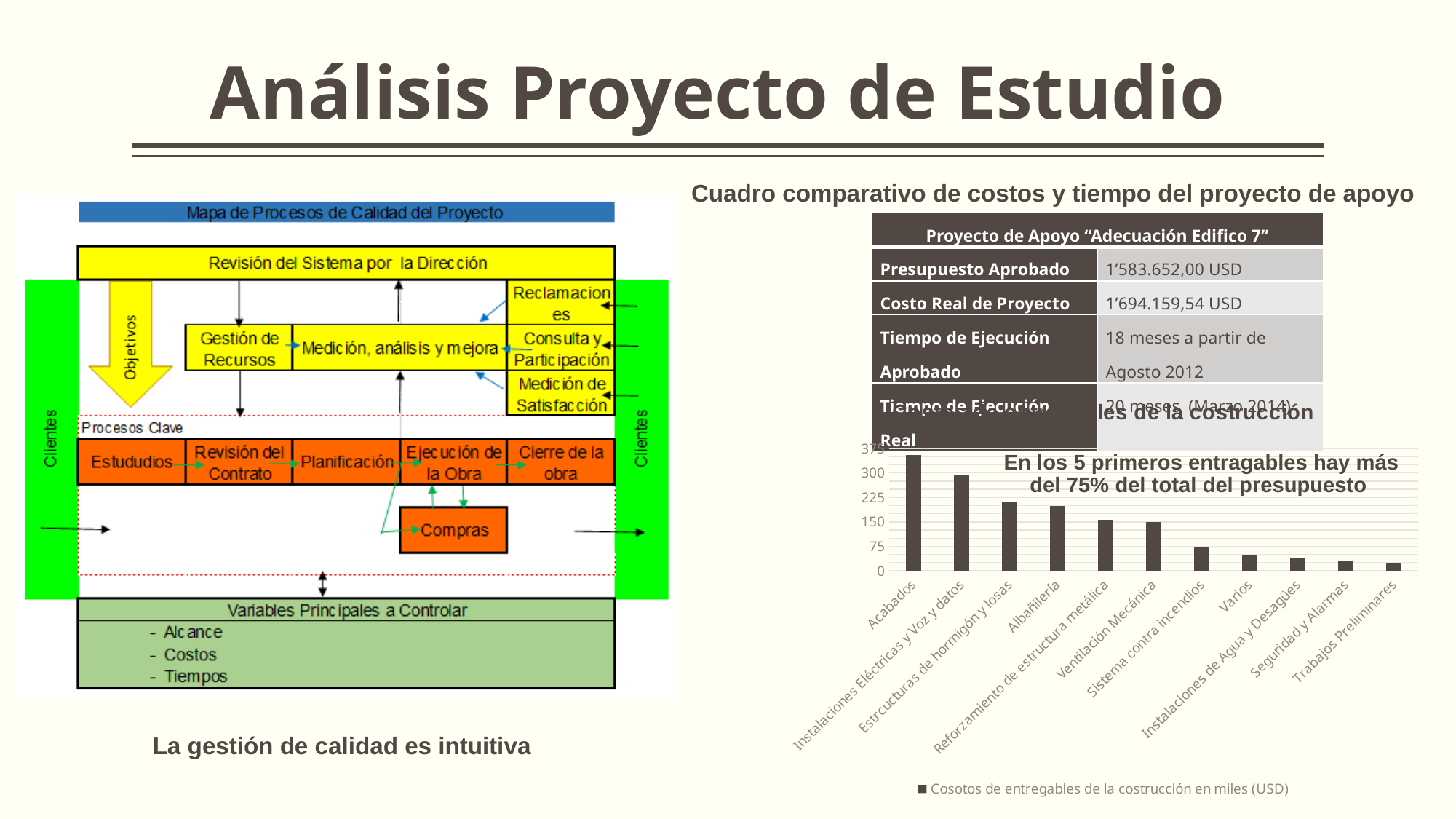
Is the value for Sistema contra incendios greater or less than 150? less What kind of chart is shown at the bottom right of the slide? bar chart Is the value for Estructuras de hormigón y losas greater or less than 150? greater Do the bar values rise or fall from left to right along the x axis? fall How many series does the legend of the bar chart list? 1 Which category has the lowest bar in the chart? Trabajos Preliminares Is the value for Acabados greater or less than 300? greater What does the legend of the bar chart say the series represents? Cosotos de entregables de la costrucción en miles (USD) Which is larger, the value for Acabados or the value for Varios? Acabados How many categories (entregables) are plotted in the bar chart? 11 Which category has the highest bar in the chart? Acabados